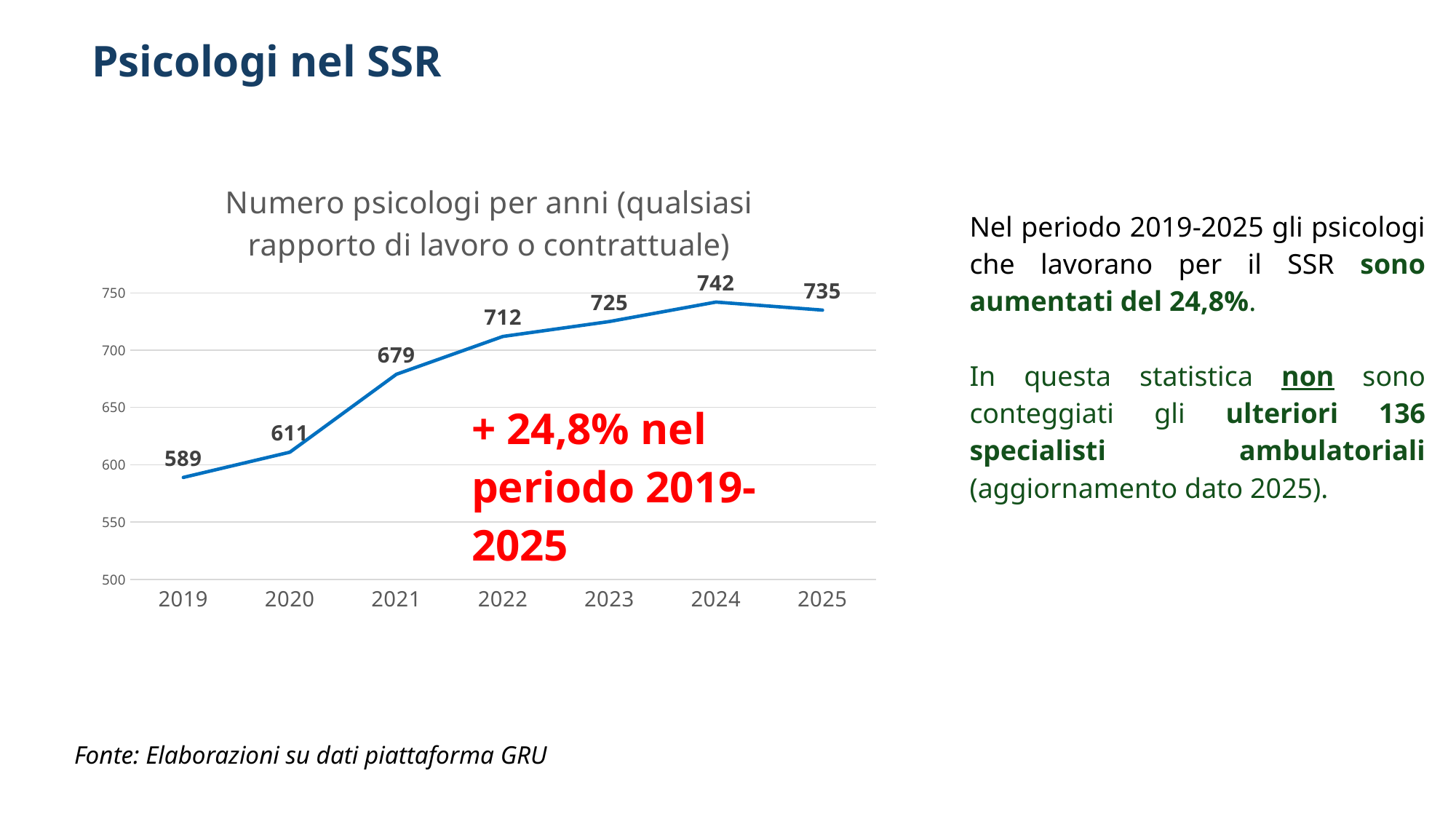
What is the number of psychologists in 2019? 589 What is the number of psychologists in 2022? 712 Which year has a larger value, 2023 or 2025? 2025 What is the number of psychologists in 2025? 735 Which year has the highest number of psychologists? 2024 What is the title of the chart? Numero psicologi per anni (qualsiasi rapporto di lavoro o contrattuale) What kind of chart is shown on the slide? Line chart Which year has the lowest number of psychologists? 2019 What is the difference between the values for 2021 and 2020? 68 What is the difference between the number of psychologists in 2025 and in 2019? 146 How many years are plotted on the chart? 7 Is the value for 2021 greater or less than 650? greater